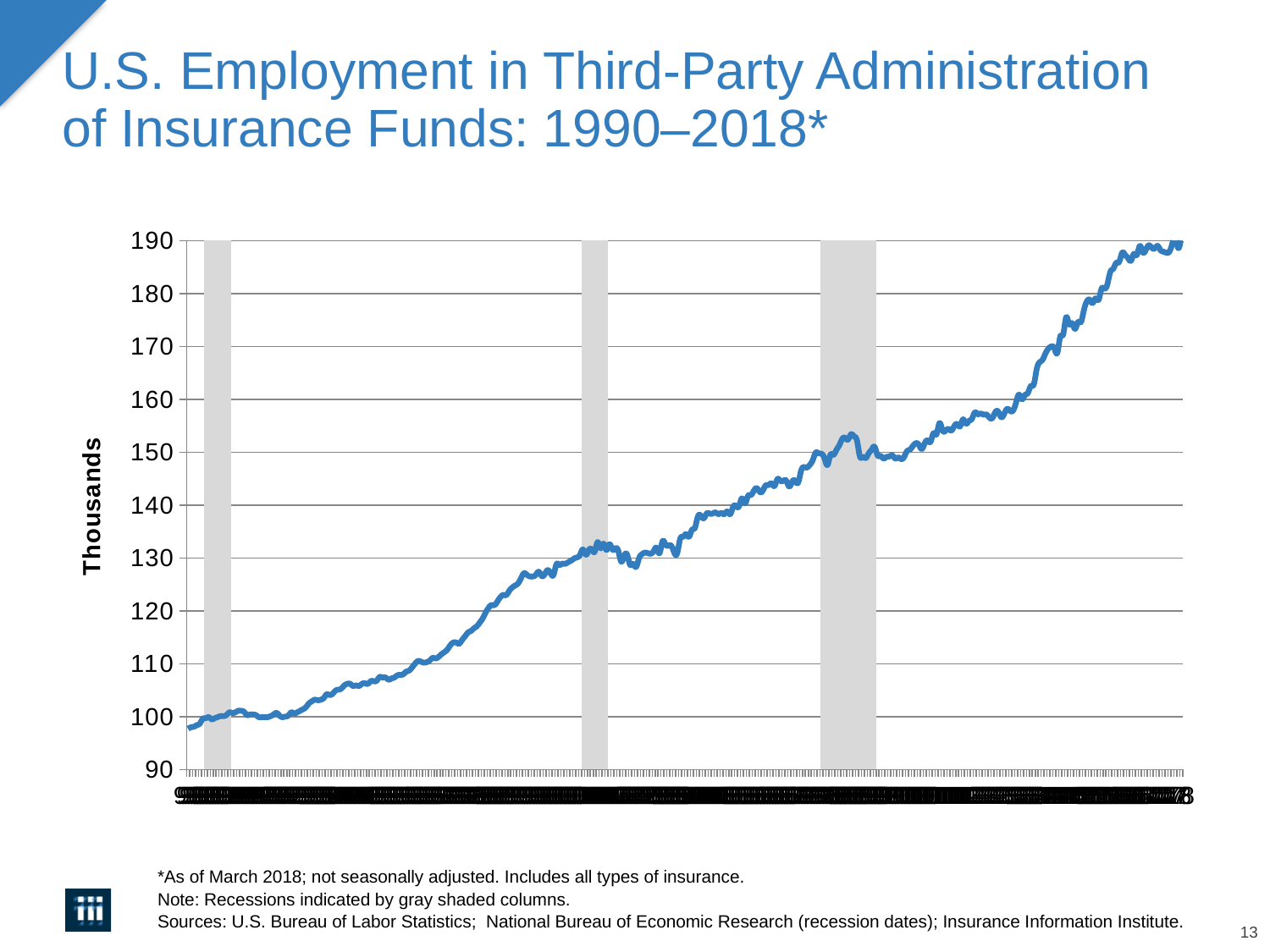
According to the note, what do the gray shaded columns indicate? Recessions Is the value at the end of the series (2018) greater or less than 180? greater Is the lowest point of the line greater or less than 110? less Is the highest point of the line greater or less than 180? greater What is the label on the vertical axis? Thousands Overall, do the values rise or fall from 1990 to 2018 along the x axis? rise What kind of chart is shown on the slide? line chart What is the highest value shown on the vertical axis? 190